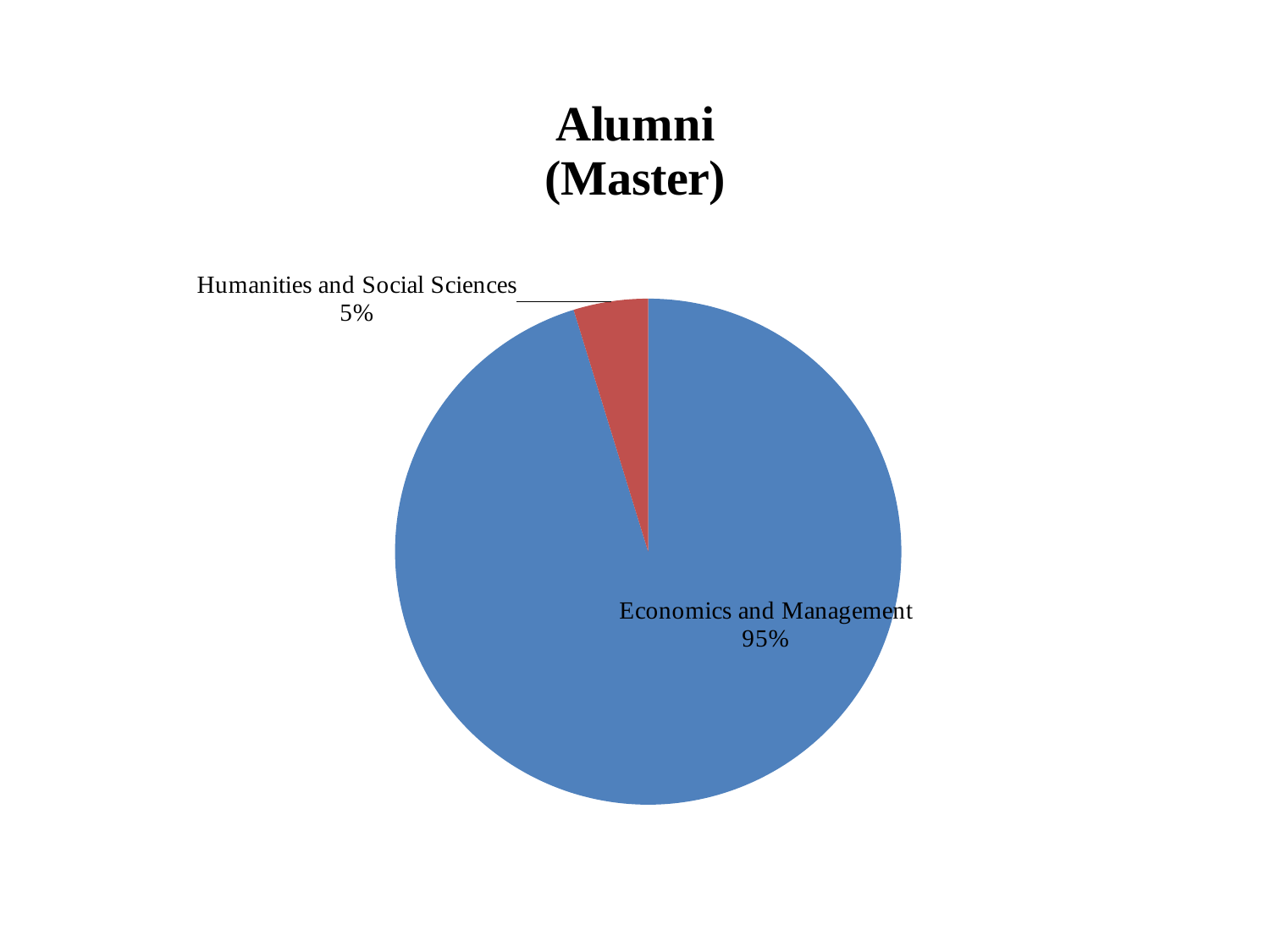
Which category has the largest share of the pie? Economics and Management What colour is the slice for Humanities and Social Sciences? Red What is the difference in percentage points between Economics and Management and Humanities and Social Sciences? 90 What share of the pie does Economics and Management represent? 95% How many categories are shown in the pie chart? 2 What share of the pie does Humanities and Social Sciences represent? 5% Which is larger, the share for Economics and Management or the share for Humanities and Social Sciences? Economics and Management What is the title of the chart? Alumni (Master) What type of chart is shown on the slide? Pie chart What is the total of the two percentages shown on the pie chart? 100% Which category has the smallest share of the pie? Humanities and Social Sciences